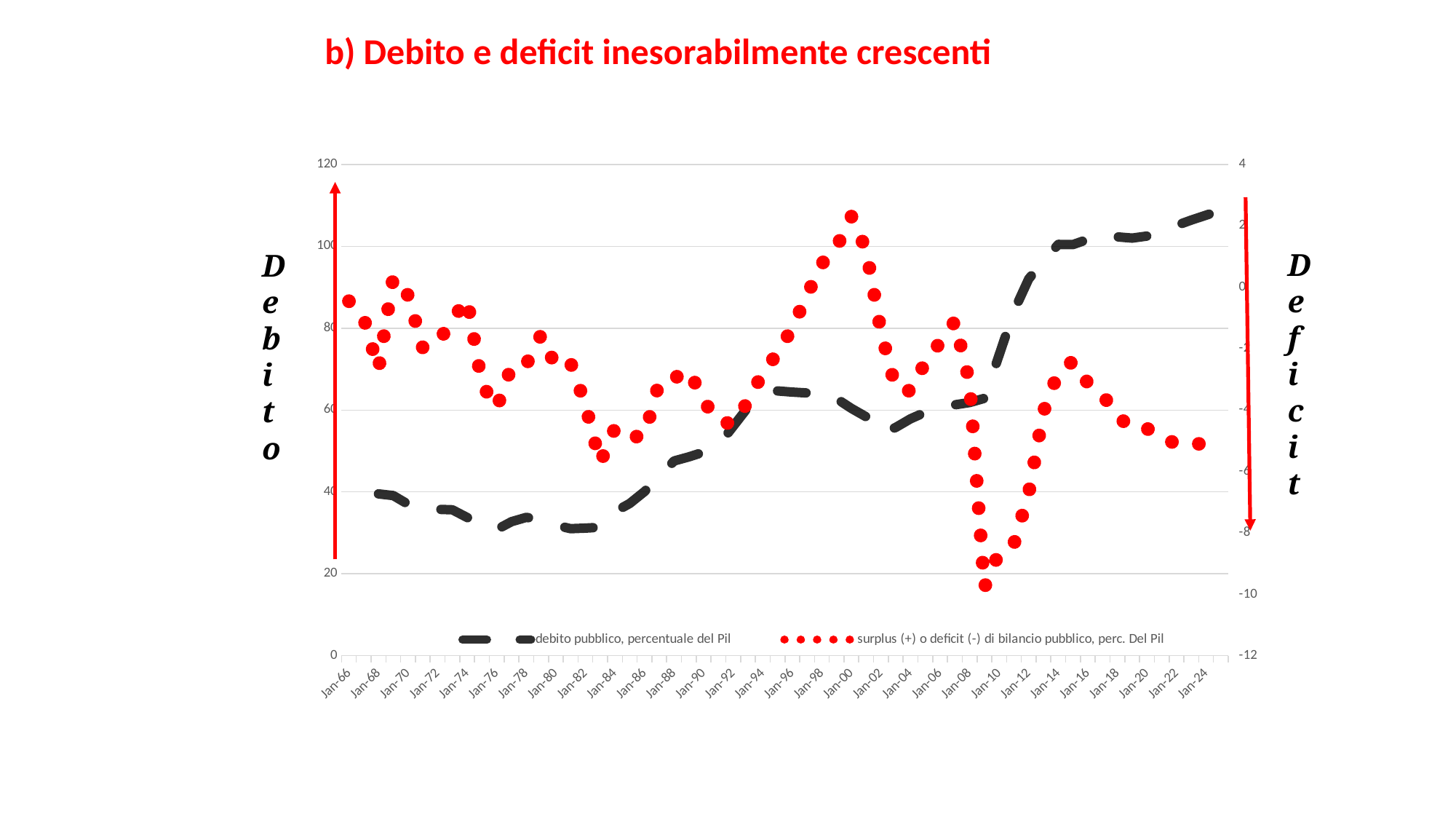
How many series does the legend list? 2 At which date does 'surplus (+) o deficit (-) di bilancio pubblico, perc. Del Pil' reach its lowest value? Jan-09 Is the value of 'surplus (+) o deficit (-) di bilancio pubblico, perc. Del Pil' at Jan-00 greater or less than 0? greater Is the value of 'surplus (+) o deficit (-) di bilancio pubblico, perc. Del Pil' at Jan-10 greater or less than -8? less Which series is drawn as a red dotted line? surplus (+) o deficit (-) di bilancio pubblico, perc. Del Pil Does 'debito pubblico, percentuale del Pil' rise or fall overall from Jan-76 to Jan-24? rise What kind of chart is shown on the slide? line chart Is the value of 'debito pubblico, percentuale del Pil' at Jan-24 greater or less than 100? greater What is the title of the slide? b) Debito e deficit inesorabilmente crescenti Which is larger: 'debito pubblico, percentuale del Pil' at Jan-68 or at Jan-24? Jan-24